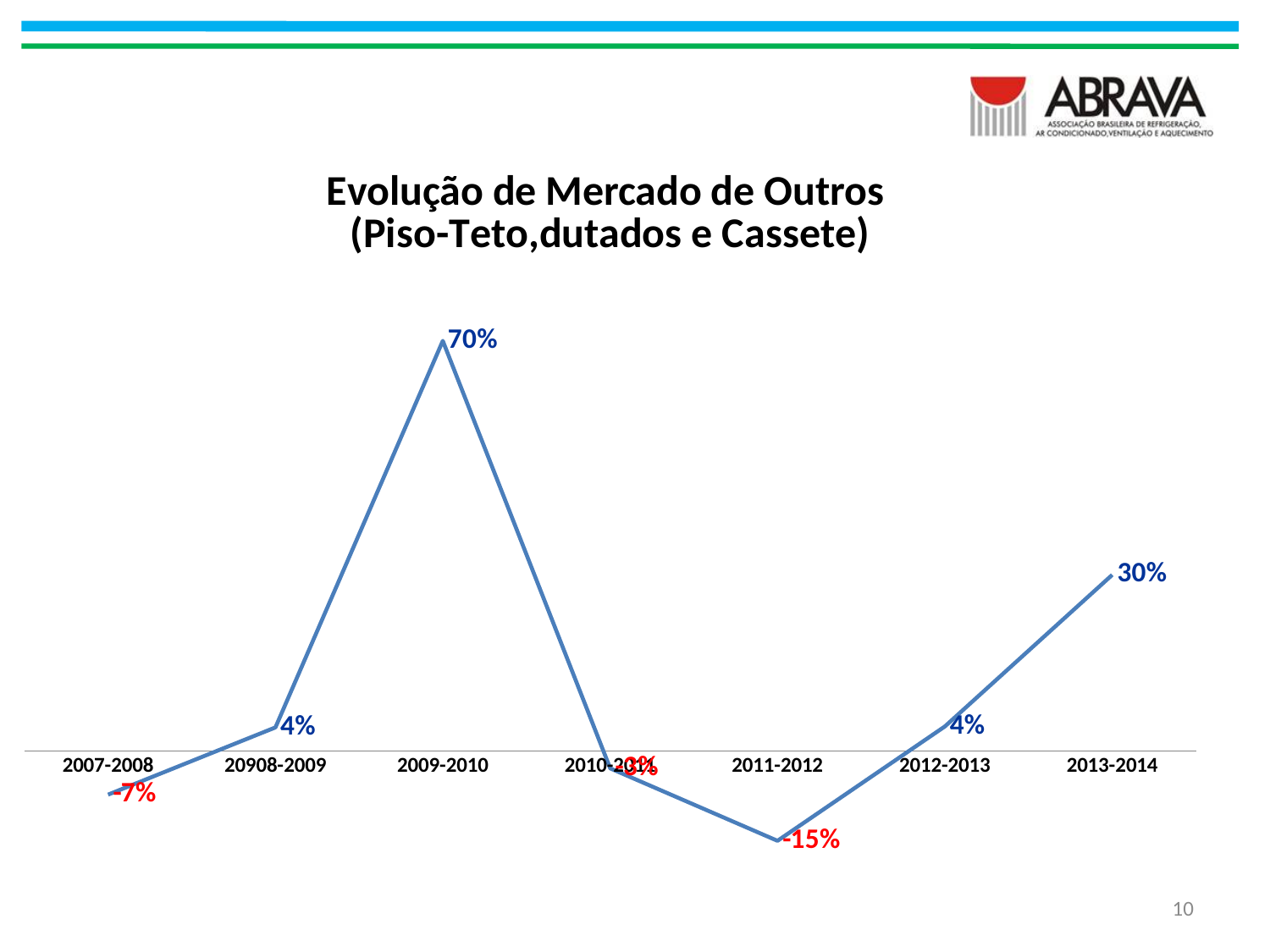
What is the difference between the values for 2009-2010 and 2013-2014? 40 percentage points What is the value for 2013-2014? 30% What is the value for 2012-2013? 4% How many periods are plotted on the x axis? 7 What is the value for 2009-2010? 70% Which period has the lowest value? 2011-2012 What is the value for 2011-2012? -15% What is the value for 2007-2008? -7% Which is larger, the value for 2012-2013 or the value for 2013-2014? 2013-2014 What kind of chart is shown? Line chart Which period has the highest value? 2009-2010 Do the values rise or fall from 2011-2012 to 2013-2014? Rise